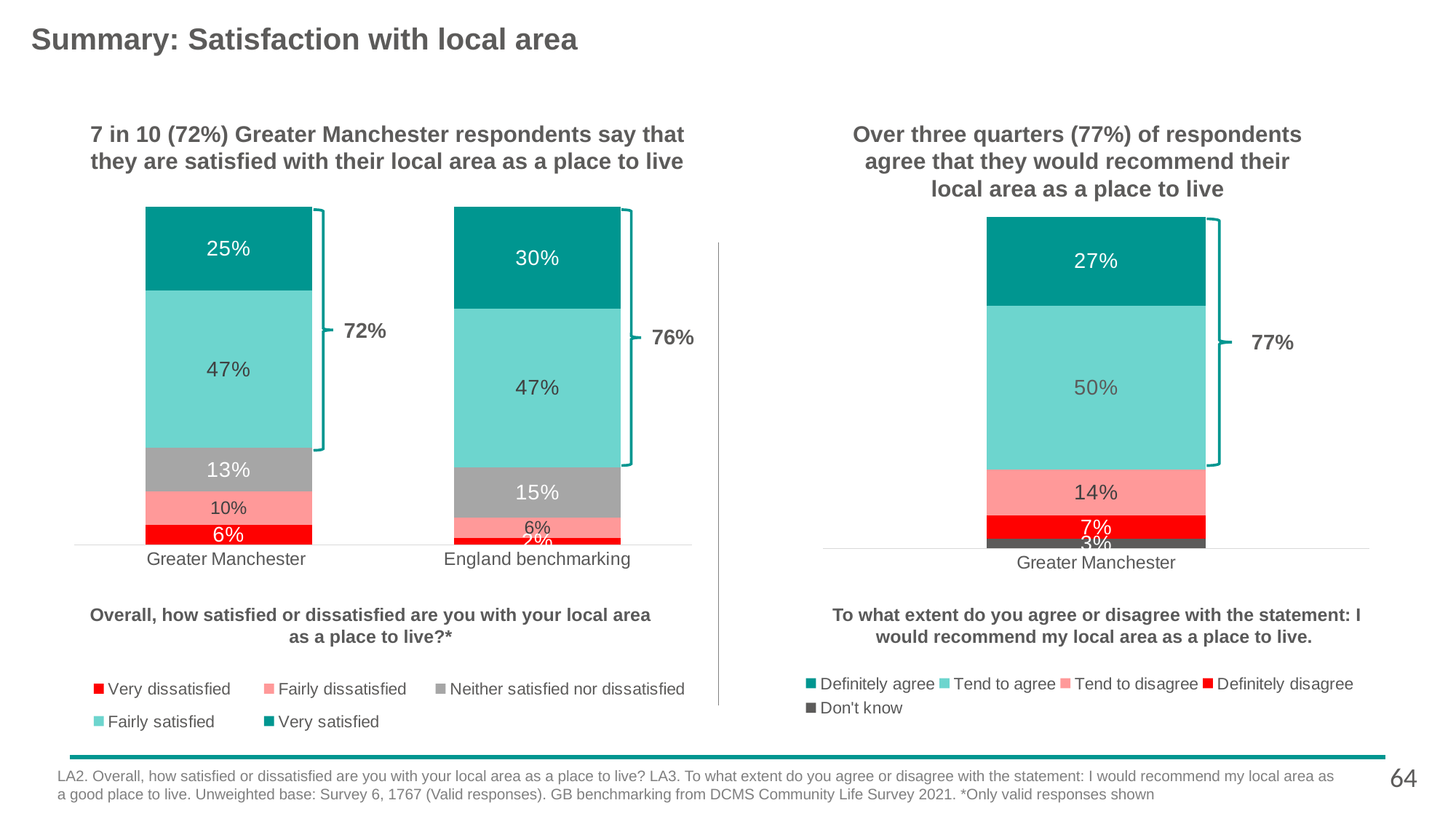
In the right chart, what is the 'Don't know' value for Greater Manchester? 3% In the left chart, what is the difference between the 'Very satisfied' values for England benchmarking and Greater Manchester? 5% In the right chart, which response category has the highest value? Tend to agree How many series does the legend of the left chart list? 5 In the right chart, what percentage of respondents 'Tend to agree'? 50% What kind of chart is the left chart? Stacked bar chart In the left chart, what percentage of Greater Manchester respondents are 'Very satisfied'? 25% In the left chart, what is the 'Very dissatisfied' value for England benchmarking? 2% In the left chart, which bar has the larger 'Fairly dissatisfied' value, Greater Manchester or England benchmarking? Greater Manchester In the right chart, what is the difference between 'Tend to disagree' and 'Definitely disagree'? 7% In the left chart, what percentage of England benchmarking respondents are 'Neither satisfied nor dissatisfied'? 15% In the left chart, what combined satisfied percentage is shown by the bracket for England benchmarking? 76%